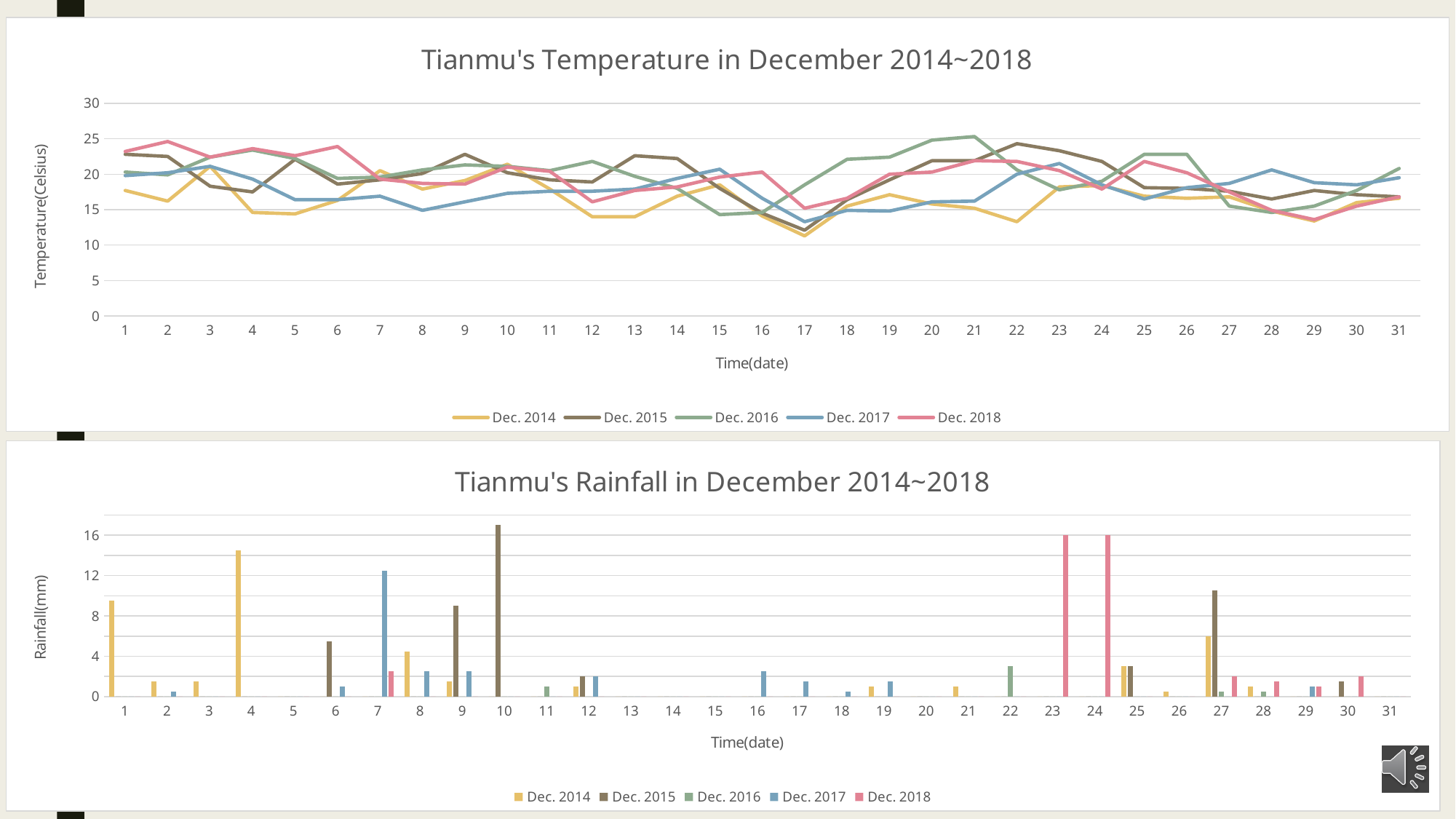
In the rainfall chart, what is the label of the y axis? Rainfall(mm) In the temperature chart, how many dates are shown on the x axis? 31 In the rainfall chart, which series has the tallest bar on date 10? Dec. 2015 In the temperature chart, which series has the lowest value on date 4? Dec. 2014 In the rainfall chart, on which date does Dec. 2014 have its highest rainfall? 4 In the temperature chart, is the Dec. 2018 value on date 2 greater or less than 20? greater In the rainfall chart, is the Dec. 2018 value on date 23 greater or less than 12? greater In the temperature chart, is the Dec. 2015 value on date 17 greater or less than 15? less What kind of chart is "Tianmu's Temperature in December 2014~2018"? line chart In the temperature chart, which series has the highest value on date 21? Dec. 2016 What kind of chart is "Tianmu's Rainfall in December 2014~2018"? bar chart In the temperature chart, how many series does the legend list? 5